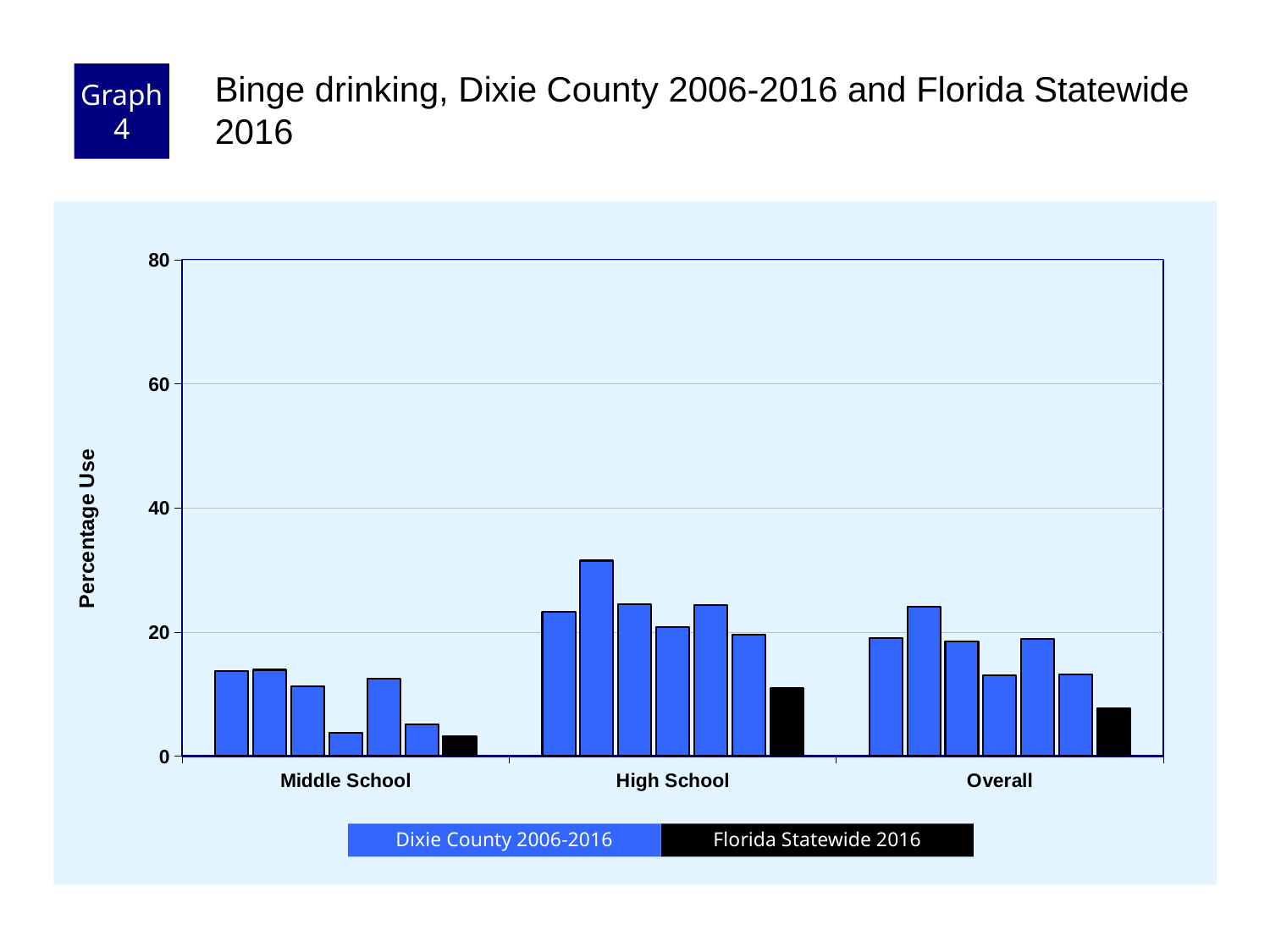
Which category has the tallest bar in the chart? High School How many series does the legend list? 2 What is the title of the y axis? Percentage Use Are all the Middle School bars greater or less than 20? less Is the Florida Statewide 2016 value for Middle School greater or less than 20? less How many categories are shown on the x axis? 3 What kind of chart is shown on the slide? bar chart Is the tallest Dixie County 2006-2016 bar for High School greater or less than 20? greater Which category has the lowest Florida Statewide 2016 value? Middle School Which colour represents Florida Statewide 2016 in the legend? black Which is larger, the Florida Statewide 2016 value for High School or for Overall? High School